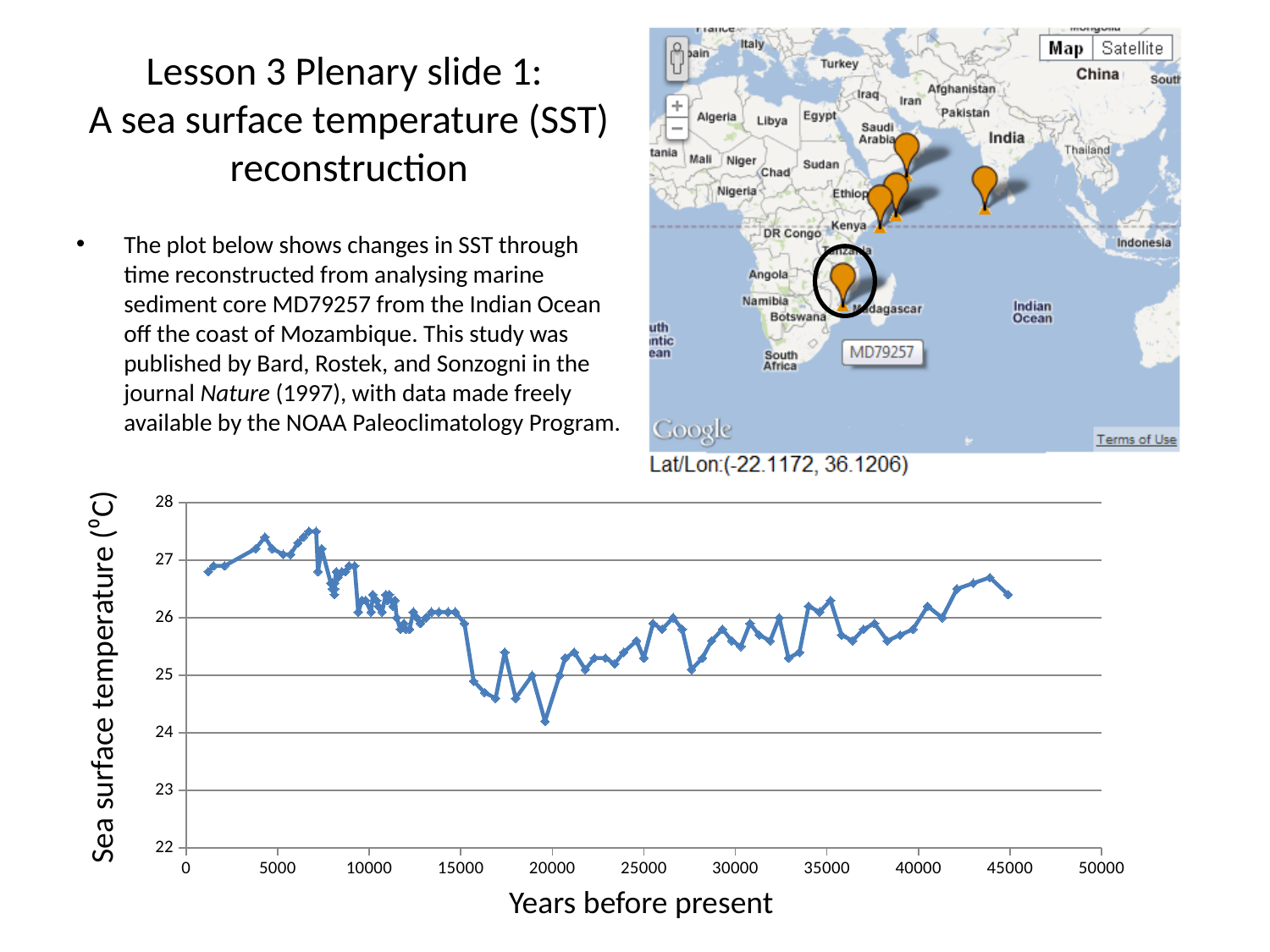
Is the sea surface temperature at around 17000 years before present greater or less than 25? less What is the label of the x axis of the chart? Years before present Is the sea surface temperature at around 45000 years before present greater or less than 26? greater What kind of chart is shown on the slide? line chart Is the sea surface temperature at around 20000 years before present greater or less than 25? less Between about 10000 and 20000 years before present, do the sea surface temperature values rise or fall as years before present increase? fall Is the sea surface temperature at around 4000 years before present larger or smaller than at around 20000 years before present? larger What is the label of the y axis of the chart? Sea surface temperature (°C) Between about 20000 and 45000 years before present, do the sea surface temperature values generally rise or fall as years before present increase? rise